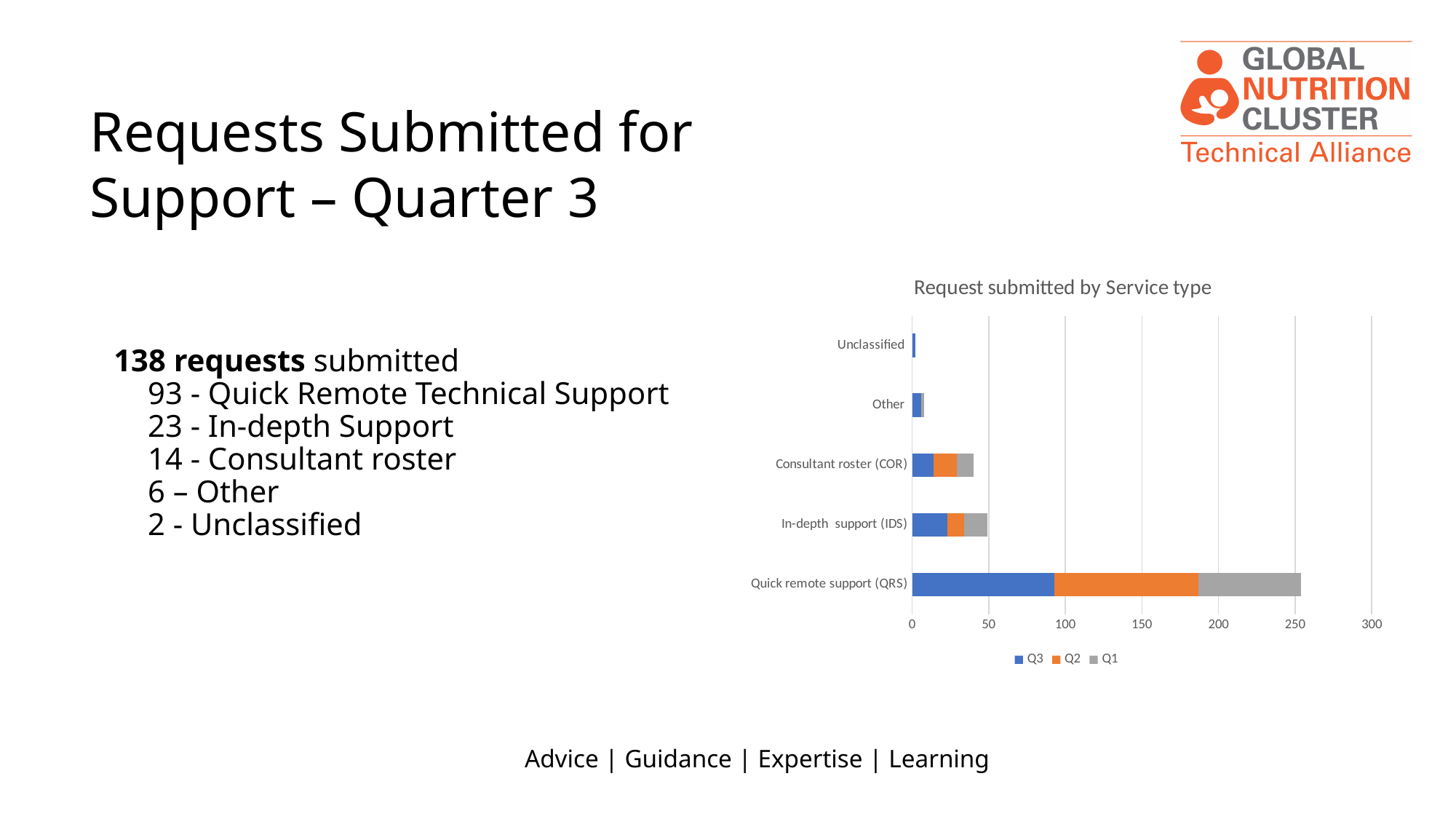
Which has the longer total bar, In-depth support (IDS) or Consultant roster (COR)? In-depth support (IDS) What kind of chart is shown on the slide? bar chart Is the total bar for Quick remote support (QRS) greater or less than 200? greater Is the total bar for Consultant roster (COR) greater or less than 50? less What is the title of the chart? Request submitted by Service type Which service type has the longest total bar in the chart? Quick remote support (QRS) Which series are listed in the chart legend? Q3, Q2, Q1 Is the Q3 segment for Quick remote support (QRS) greater or less than 50? greater How many series does the chart legend list? 3 How many service type categories are plotted in the chart? 5 Which service type has the shortest total bar in the chart? Unclassified